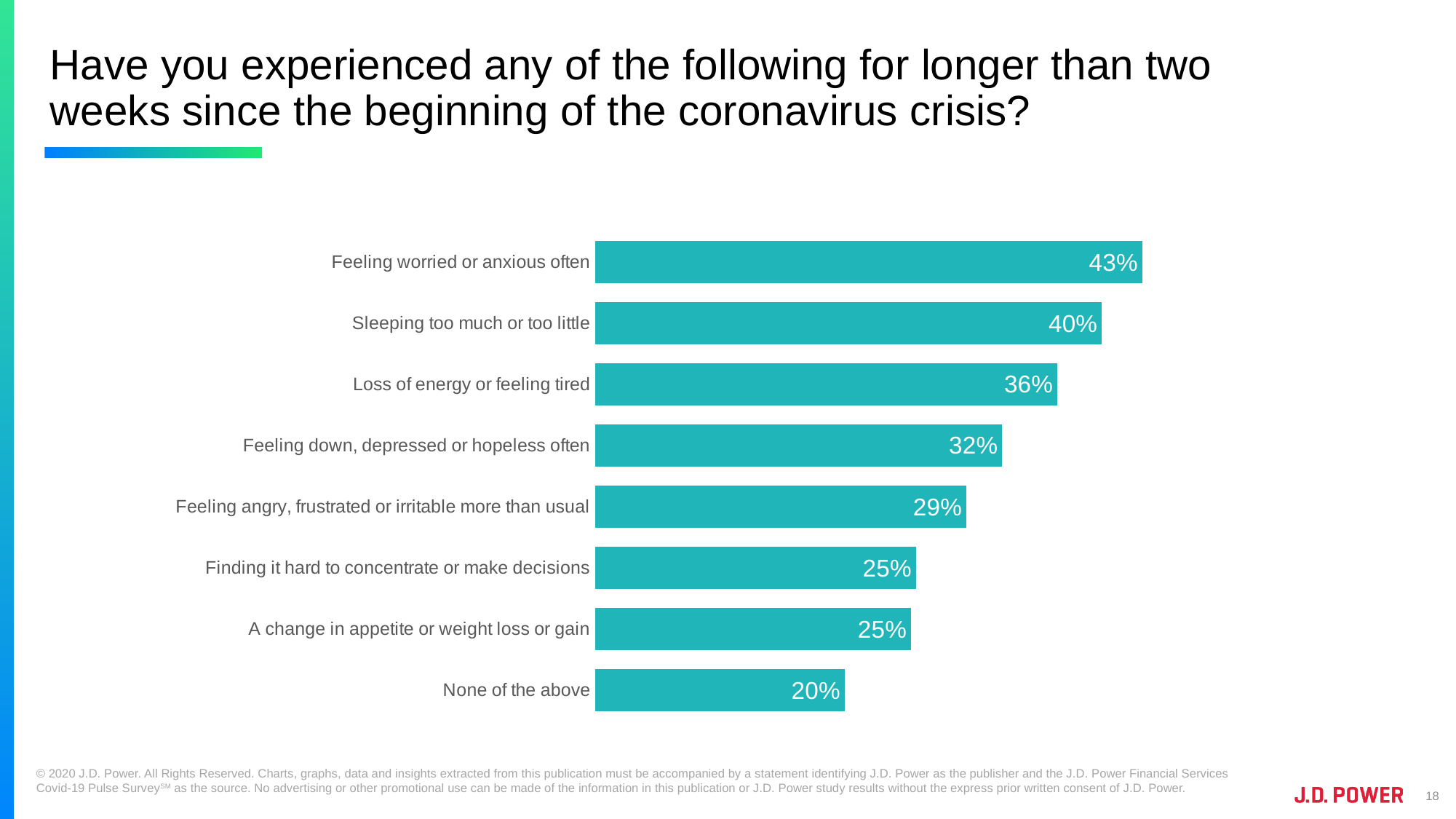
How many categories are shown in the chart? 8 Which category has the lowest value? None of the above What is the value for 'Feeling angry, frustrated or irritable more than usual'? 29% Which is larger: 'Loss of energy or feeling tired' or 'Finding it hard to concentrate or make decisions'? Loss of energy or feeling tired What kind of chart is shown on the slide? Bar chart Which category has the highest value? Feeling worried or anxious often What is the value for 'Sleeping too much or too little'? 40% Which two categories share the same value of 25%? Finding it hard to concentrate or make decisions; A change in appetite or weight loss or gain What colour are the bars in the chart? Teal What percentage of respondents reported feeling worried or anxious often? 43% What percentage selected 'None of the above'? 20% What is the difference between 'Feeling worried or anxious often' and 'Feeling down, depressed or hopeless often'? 11 percentage points